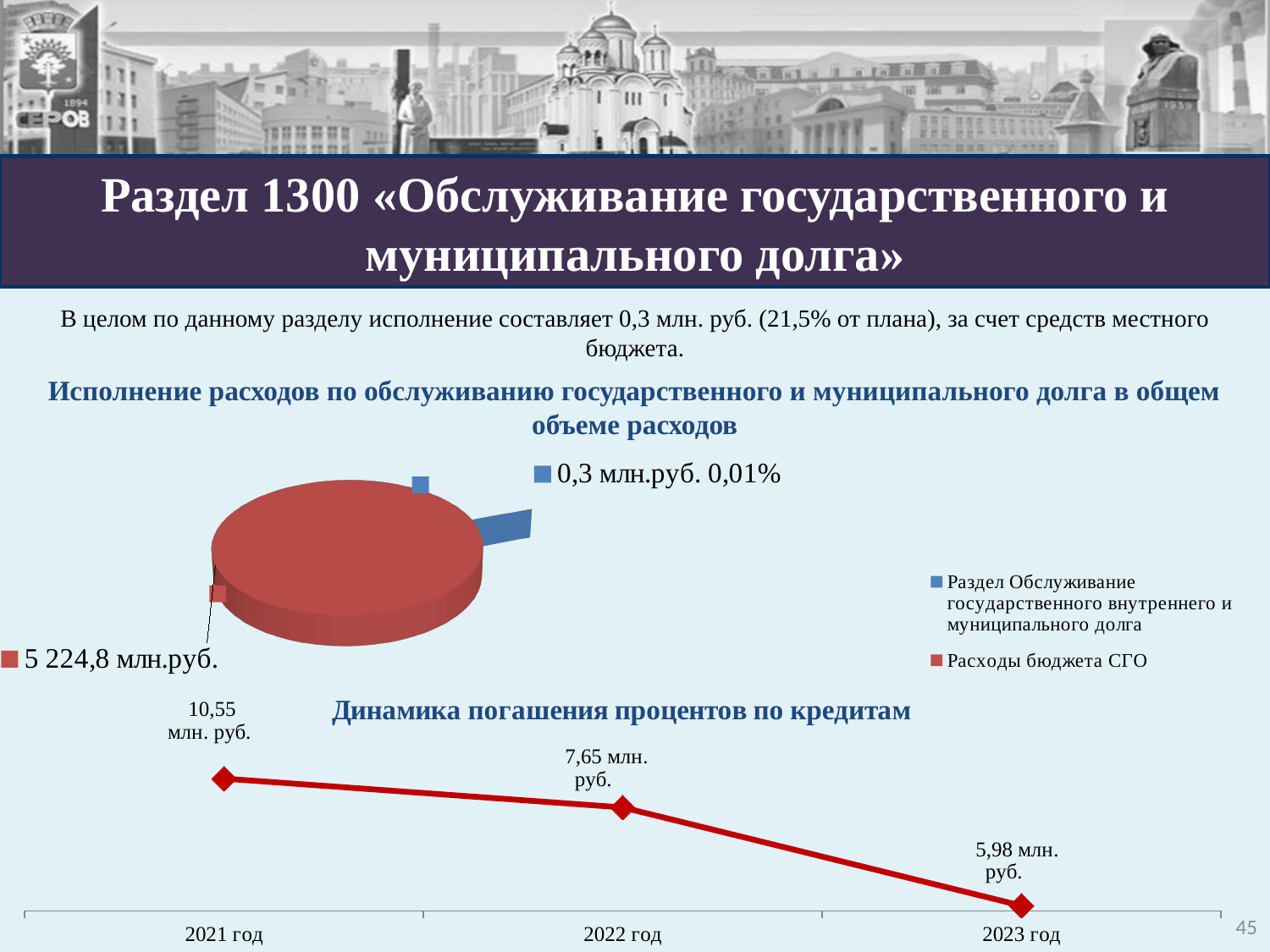
On the chart 'Динамика погашения процентов по кредитам', do the values rise or fall from 2021 год to 2023 год? fall What kind of chart is 'Динамика погашения процентов по кредитам'? line chart On the chart 'Динамика погашения процентов по кредитам', what is the value for 2023 год? 5,98 млн. руб. On the chart 'Динамика погашения процентов по кредитам', what is the value for 2022 год? 7,65 млн. руб. On the chart 'Динамика погашения процентов по кредитам', how many data points are plotted? 3 On the chart 'Динамика погашения процентов по кредитам', what is the value for 2021 год? 10,55 млн. руб. On the chart 'Динамика погашения процентов по кредитам', what is the difference between the values for 2021 год and 2023 год? 4,57 млн. руб. On the chart 'Динамика погашения процентов по кредитам', which year has the lowest value? 2023 год On the pie chart 'Исполнение расходов по обслуживанию государственного и муниципального долга в общем объеме расходов', what value is shown for the slice 'Расходы бюджета СГО'? 5 224,8 млн.руб. On the chart 'Динамика погашения процентов по кредитам', which year has the highest value? 2021 год How many entries does the legend of the pie chart 'Исполнение расходов по обслуживанию государственного и муниципального долга в общем объеме расходов' list? 2 On the pie chart 'Исполнение расходов по обслуживанию государственного и муниципального долга в общем объеме расходов', what share does the slice 'Раздел Обслуживание государственного внутреннего и муниципального долга' have? 0,01%